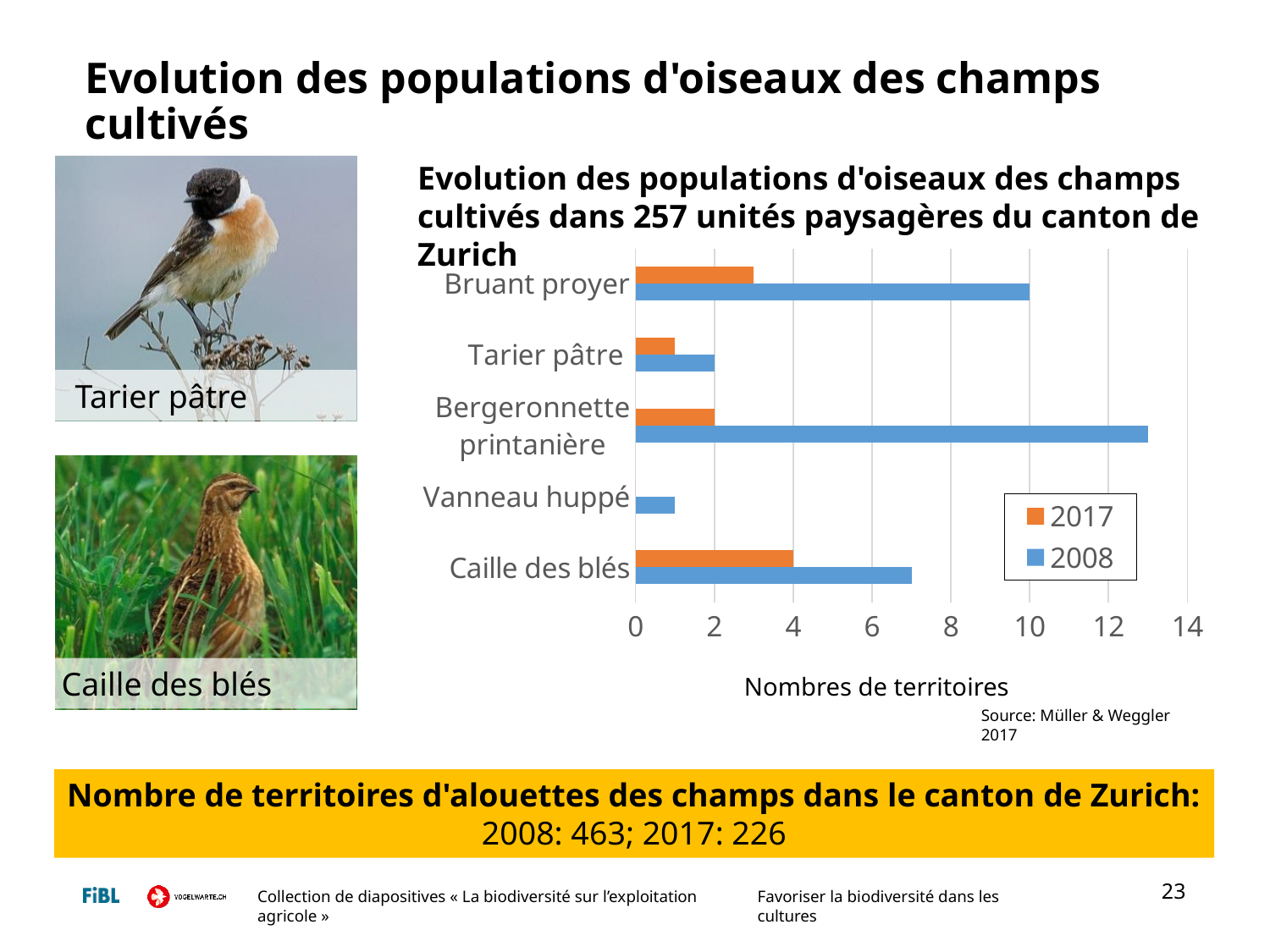
What kind of chart is shown on the slide? bar chart How many bird species (categories) are shown on the chart? 5 How many series does the chart legend list? 2 Which species has the highest number of territories in 2017? Caille des blés For Bruant proyer, which year has the larger number of territories, 2008 or 2017? 2008 What is the number of territories for Bergeronnette printanière in 2017? 2 What is the number of territories for Caille des blés in 2017? 4 What is the number of territories for Bruant proyer in 2008? 10 Is the 2008 value for Caille des blés greater or less than 6? greater What is the number of territories for Tarier pâtre in 2008? 2 Which species has the highest number of territories in 2008? Bergeronnette printanière Is the 2008 value for Bergeronnette printanière greater or less than 12? greater